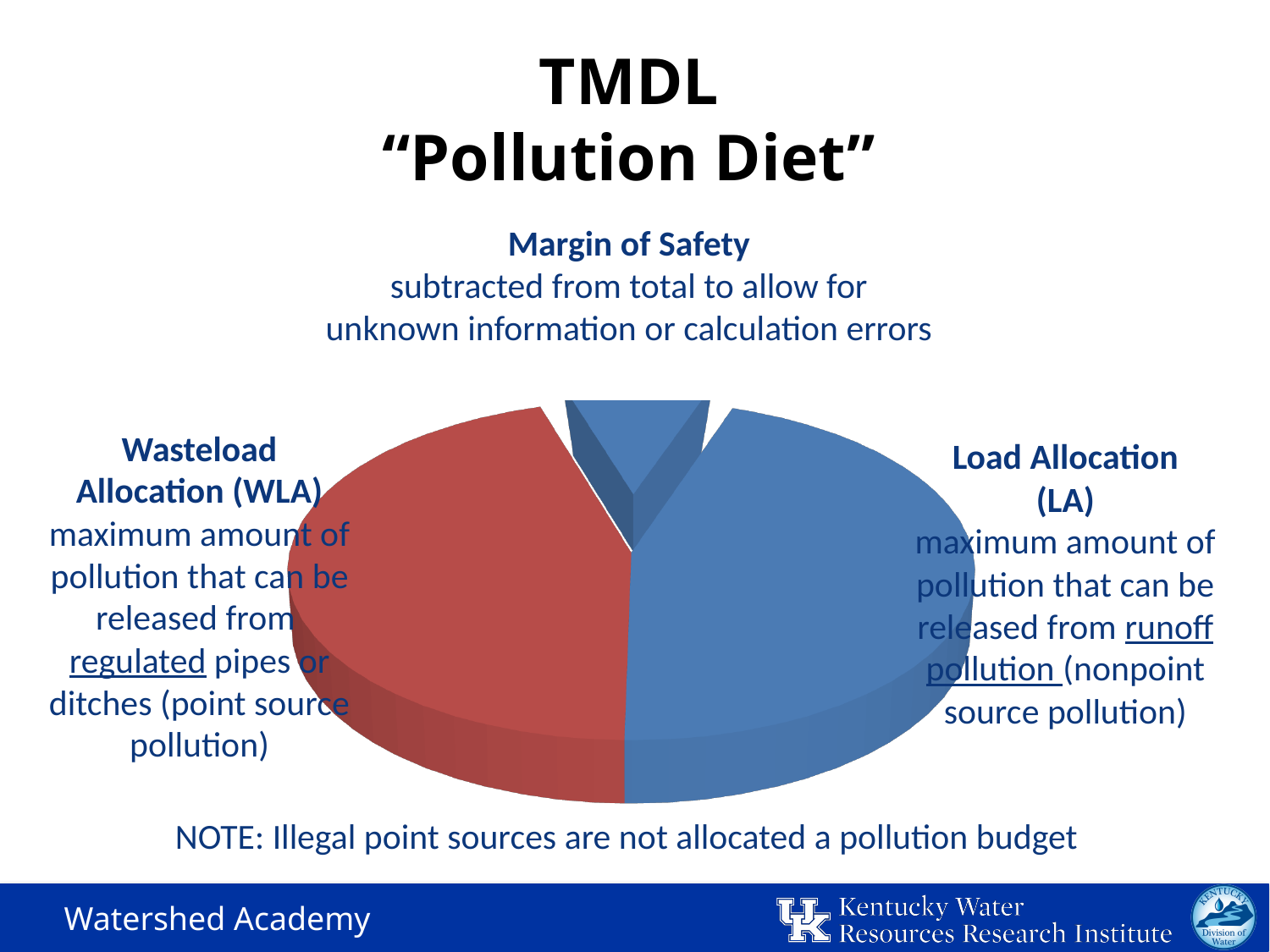
What kind of chart is shown on the slide? pie chart How many slices does the pie chart have? 3 What is the title of the slide containing the pie chart? TMDL "Pollution Diet" Which slice of the pie chart is the smallest? Margin of Safety Which is larger in the pie chart, the Wasteload Allocation (WLA) slice or the Margin of Safety slice? Wasteload Allocation (WLA) What colour is the Wasteload Allocation (WLA) slice of the pie chart? red